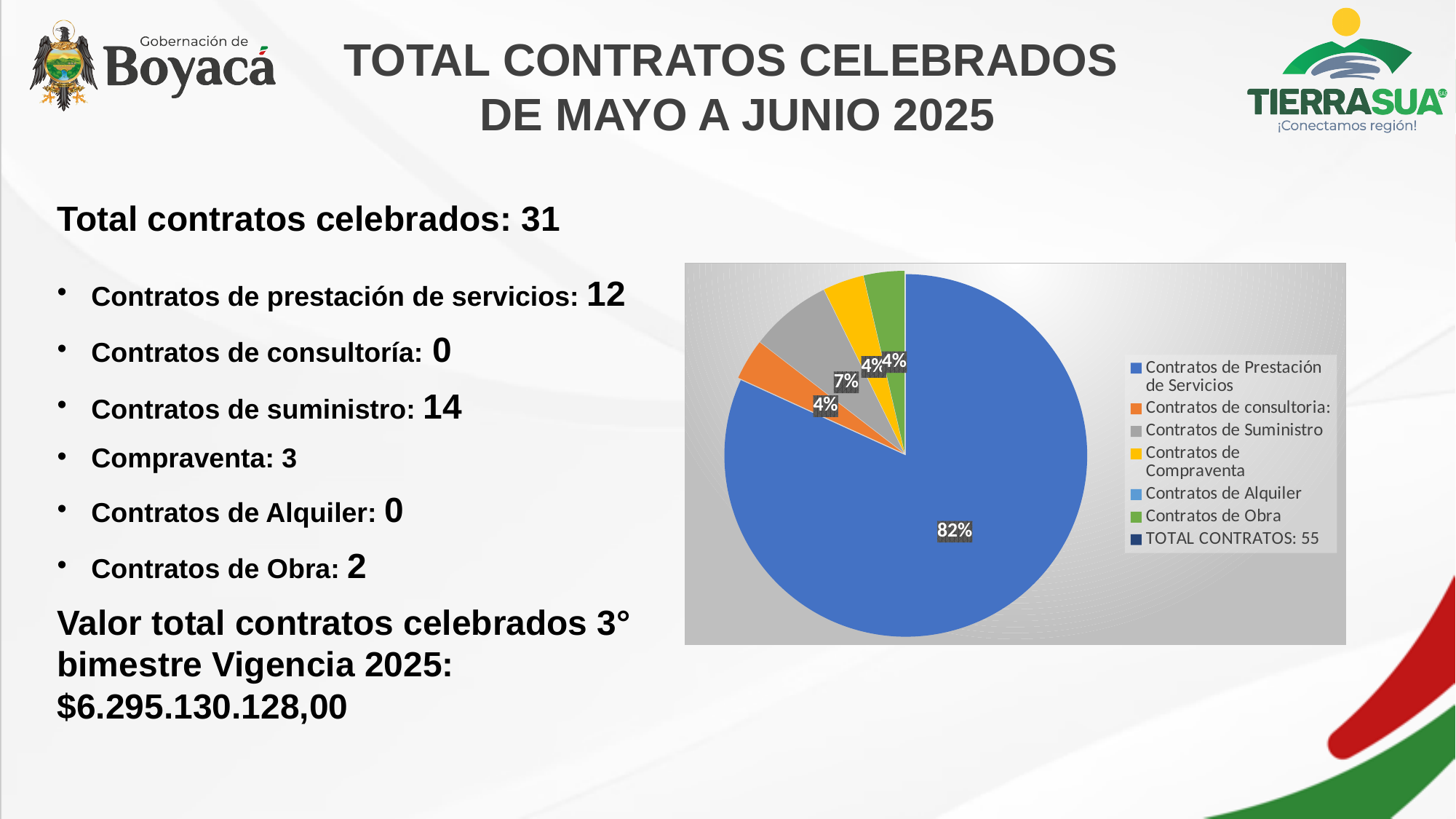
What percentage does the pie chart show for Contratos de consultoria? 4% How many entries does the pie chart's legend list? 7 What colour is the Contratos de Prestación de Servicios slice in the pie chart? blue What percentage does the pie chart show for Contratos de Prestación de Servicios? 82% What percentage does the pie chart show for Contratos de Obra? 4% How many slices with percentage labels are visible in the pie chart? 5 What kind of chart is shown on the slide? pie chart What percentage does the pie chart show for Contratos de Suministro? 7% Which slice is larger in the pie chart, Contratos de Suministro or Contratos de consultoria? Contratos de Suministro What is the difference in percentage points between the Contratos de Prestación de Servicios slice and the Contratos de Suministro slice? 75 Which category has the largest slice in the pie chart? Contratos de Prestación de Servicios What percentage does the pie chart show for Contratos de Compraventa? 4%